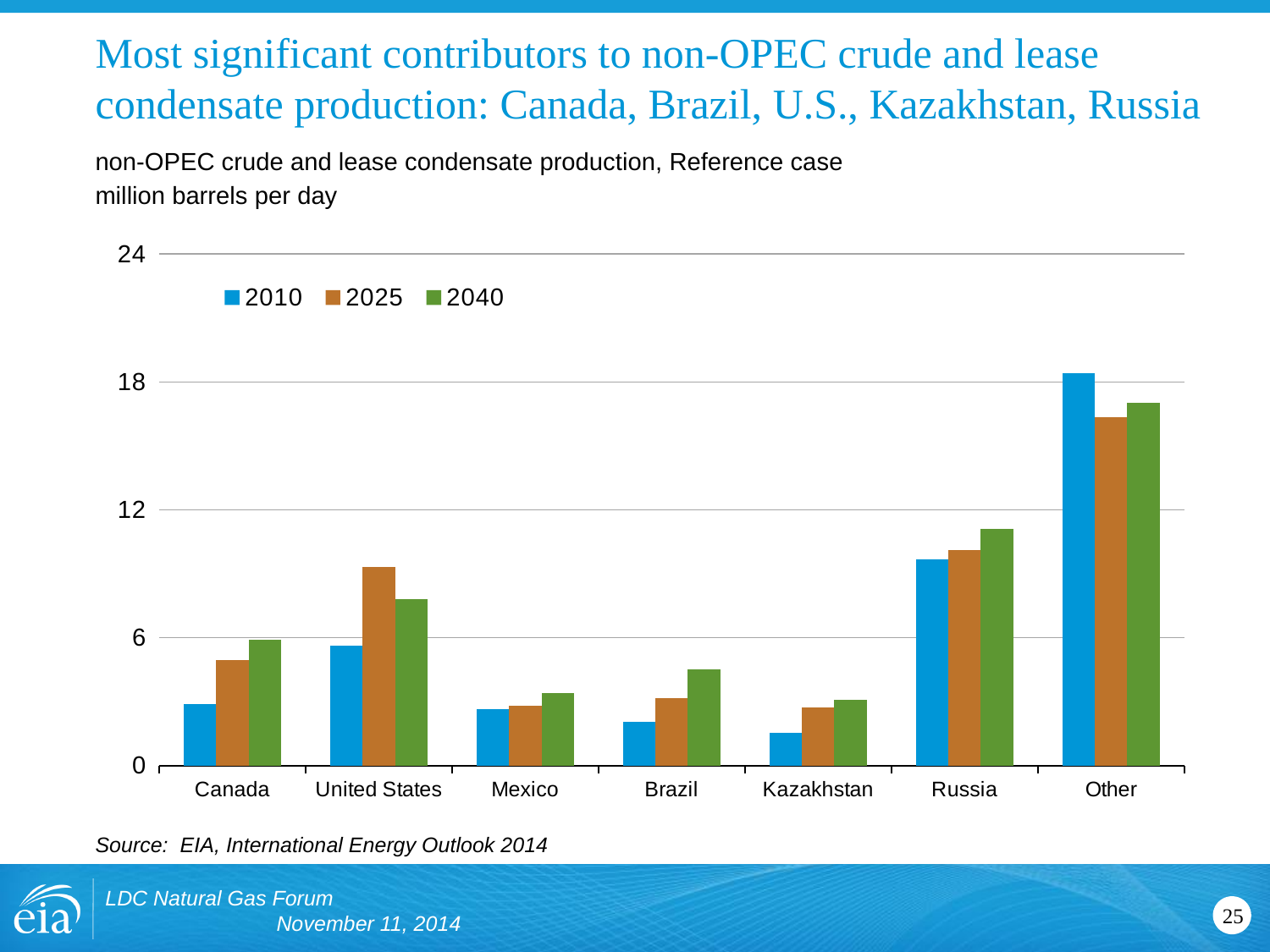
Is the value for United States in 2025 greater or less than 6? greater Which is larger, the 2025 value for United States or the 2025 value for Canada? United States How many categories are shown on the x axis? 7 Is the value for Russia in 2040 greater or less than 12? less Which category has the lowest value for 2010? Kazakhstan What unit is the chart measured in, according to the subtitle? million barrels per day Is the value for Other in 2025 greater or less than 18? less Do the values for Canada rise or fall from 2010 to 2040? rise What kind of chart is shown on the slide? bar chart Which category has the highest value for 2010? Other How many series does the legend list? 3